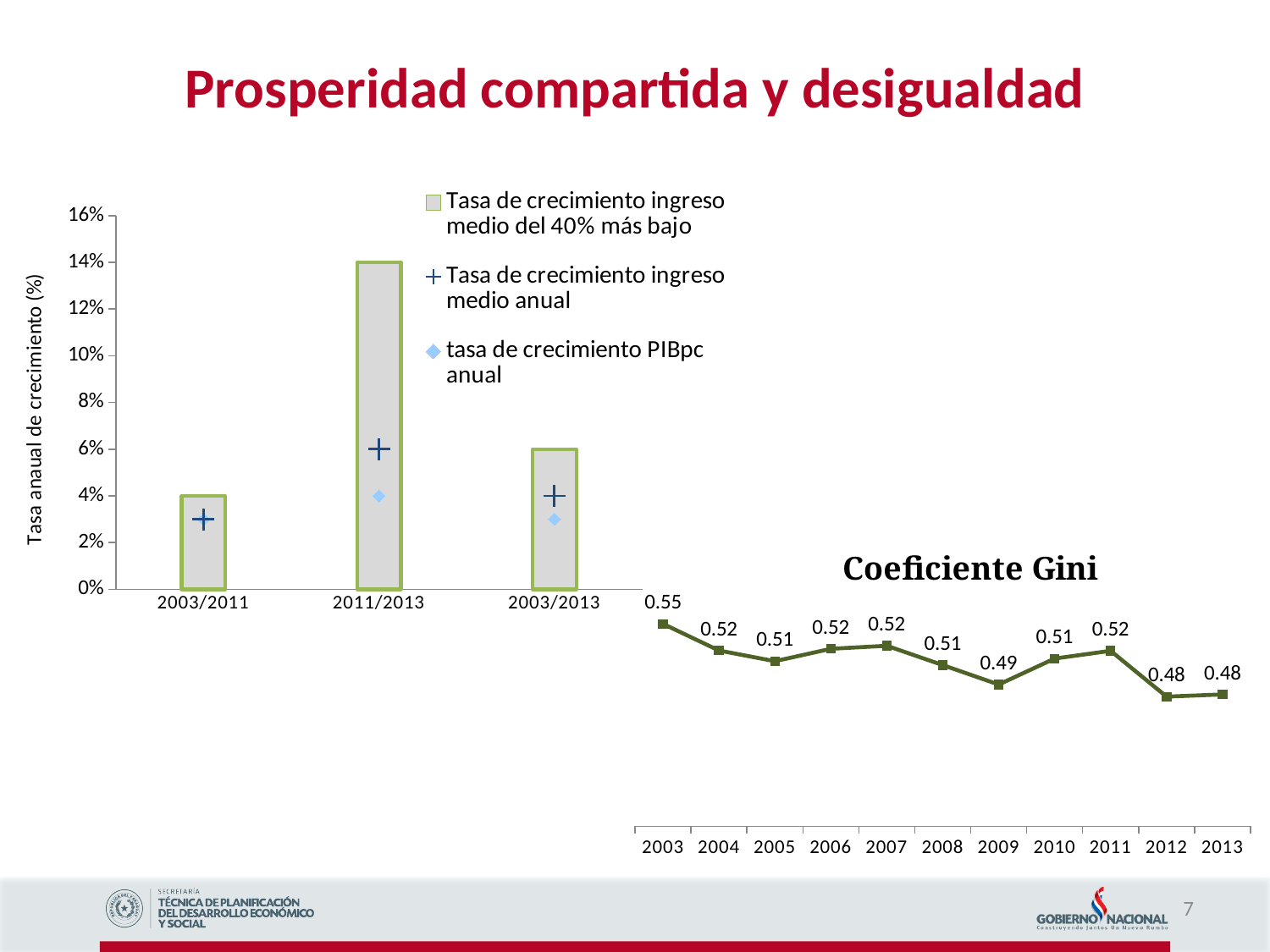
In the bar chart on the left, which period has the highest bar for 'Tasa de crecimiento ingreso medio del 40% más bajo'? 2011/2013 In the Coeficiente Gini chart, what is the difference between the values for 2003 and 2013? 0.07 In the Coeficiente Gini chart, what is the value for 2009? 0.49 In the Coeficiente Gini chart, which is larger, the value for 2011 or the value for 2012? 2011 In the Coeficiente Gini chart, what is the value for 2003? 0.55 In the bar chart on the left, what kind of chart shows the 'Tasa de crecimiento ingreso medio del 40% más bajo' series? bar chart In the Coeficiente Gini chart, which year has the highest value? 2003 In the bar chart on the left, is the bar for 2011/2013 greater or less than 10%? greater How many years are plotted in the Coeficiente Gini chart? 11 How many series does the legend of the bar chart on the left list? 3 What kind of chart is the Coeficiente Gini chart? line chart In the Coeficiente Gini chart, do the values generally rise or fall from 2003 to 2013? fall